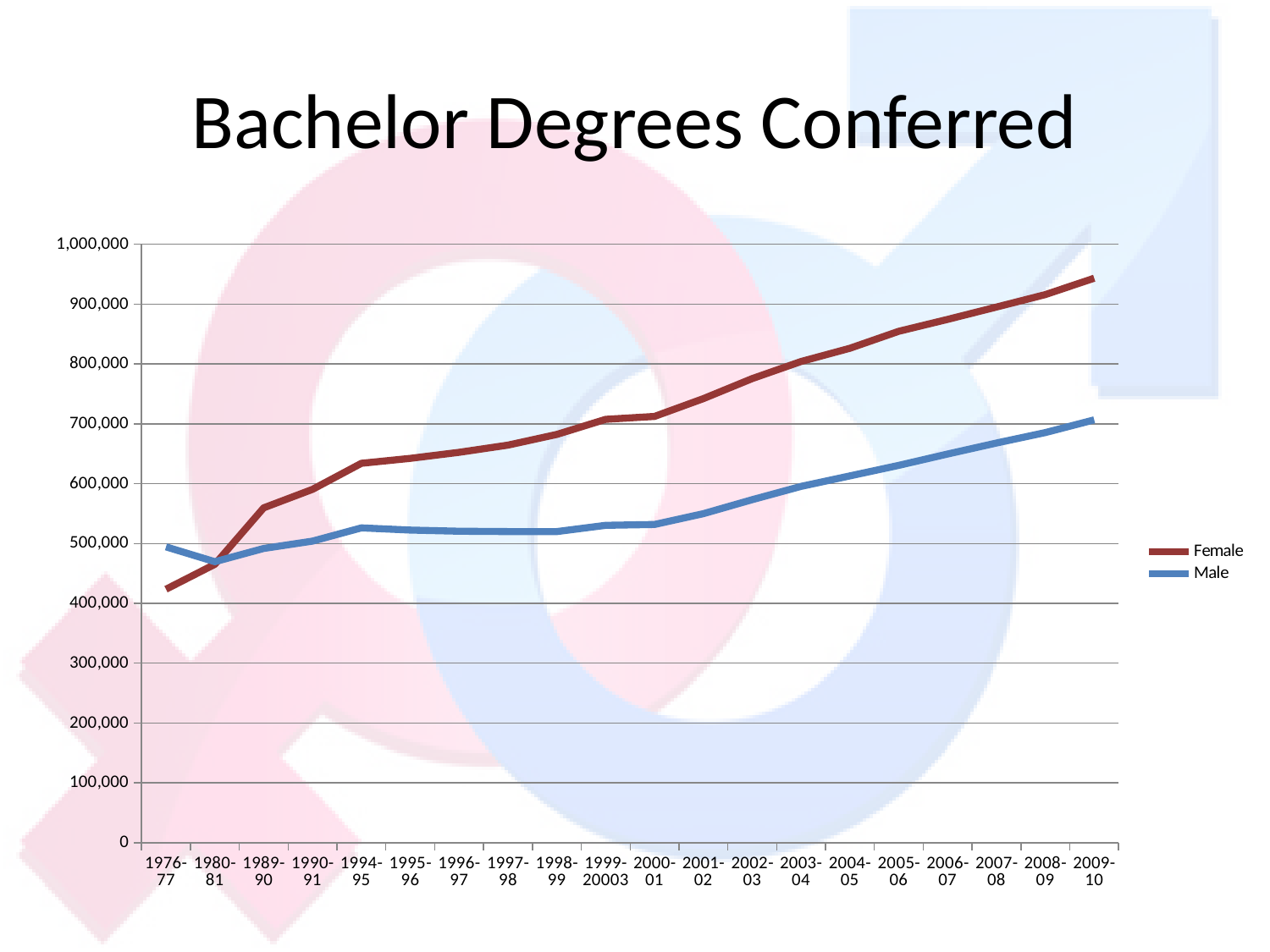
What are the two series named in the legend? Female and Male In 1976-77, which series has the higher value, Female or Male? Male Is the Female value for 2009-10 greater or less than 900,000? greater Is the Female value for 1994-95 greater or less than 600,000? greater In which year is the Female series at its highest? 2009-10 Is the Female value for 1976-77 greater or less than 500,000? less What kind of chart is shown on the slide? line chart How many academic-year categories are shown on the x axis? 20 Does the Female series generally rise or fall from 1976-77 to 2009-10? rise In 2009-10, which series has the higher value, Female or Male? Female How many series does the legend list? 2